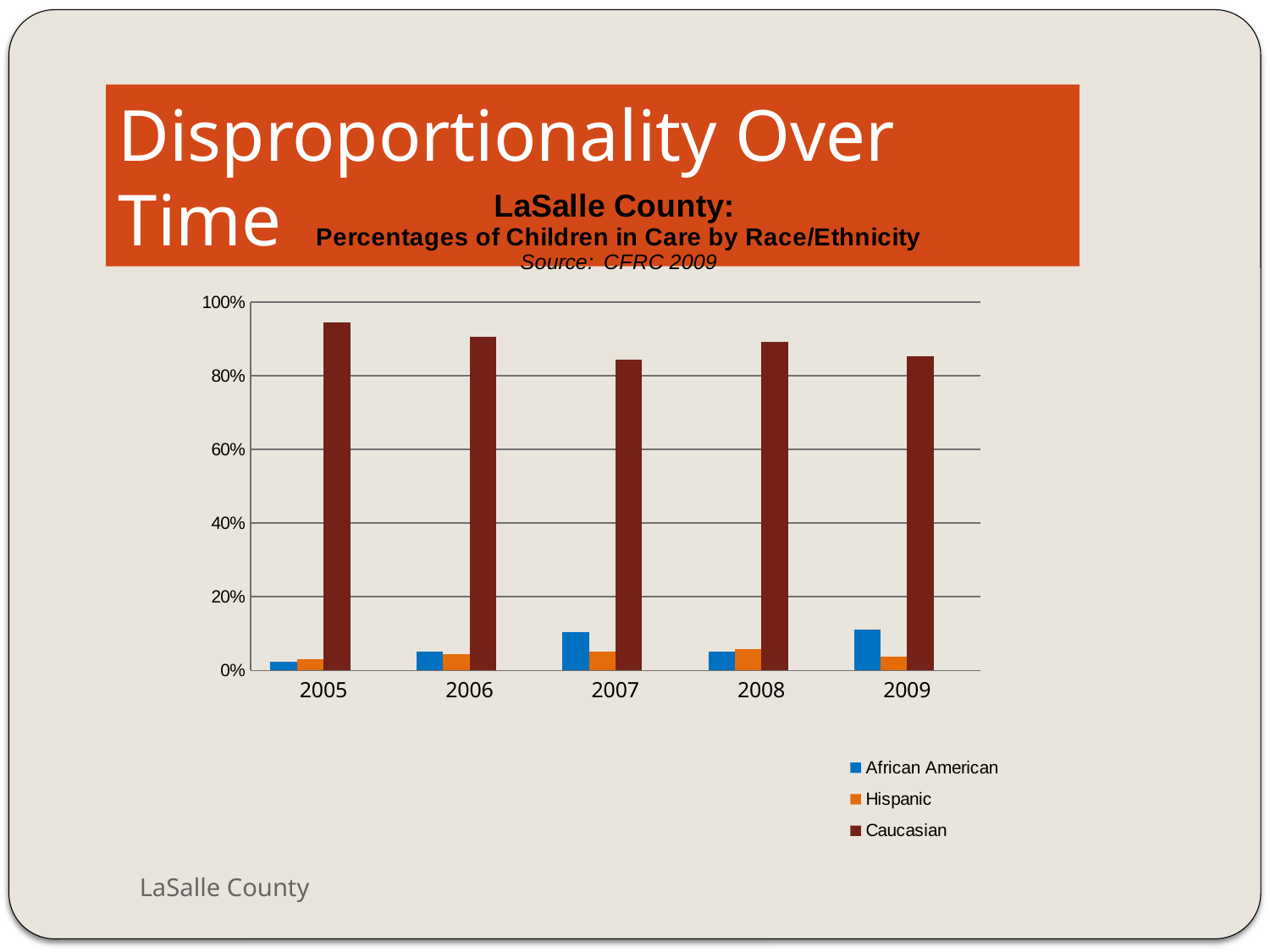
Is the Caucasian value for 2007 greater or less than 80%? greater How many series does the legend list? 3 How many years are shown on the x axis? 5 What kind of chart is shown on the slide? Bar chart In which year is the Caucasian percentage highest? 2005 What source is cited under the chart title? CFRC 2009 Is the African American value for 2009 greater or less than 20%? less In 2005, which is larger: the Caucasian percentage or the African American percentage? Caucasian Does the Caucasian percentage rise or fall from 2005 to 2007? Fall In which year is the African American percentage lowest? 2005 Is the Hispanic value for 2008 greater or less than 20%? less In 2009, which is larger: the African American percentage or the Hispanic percentage? African American